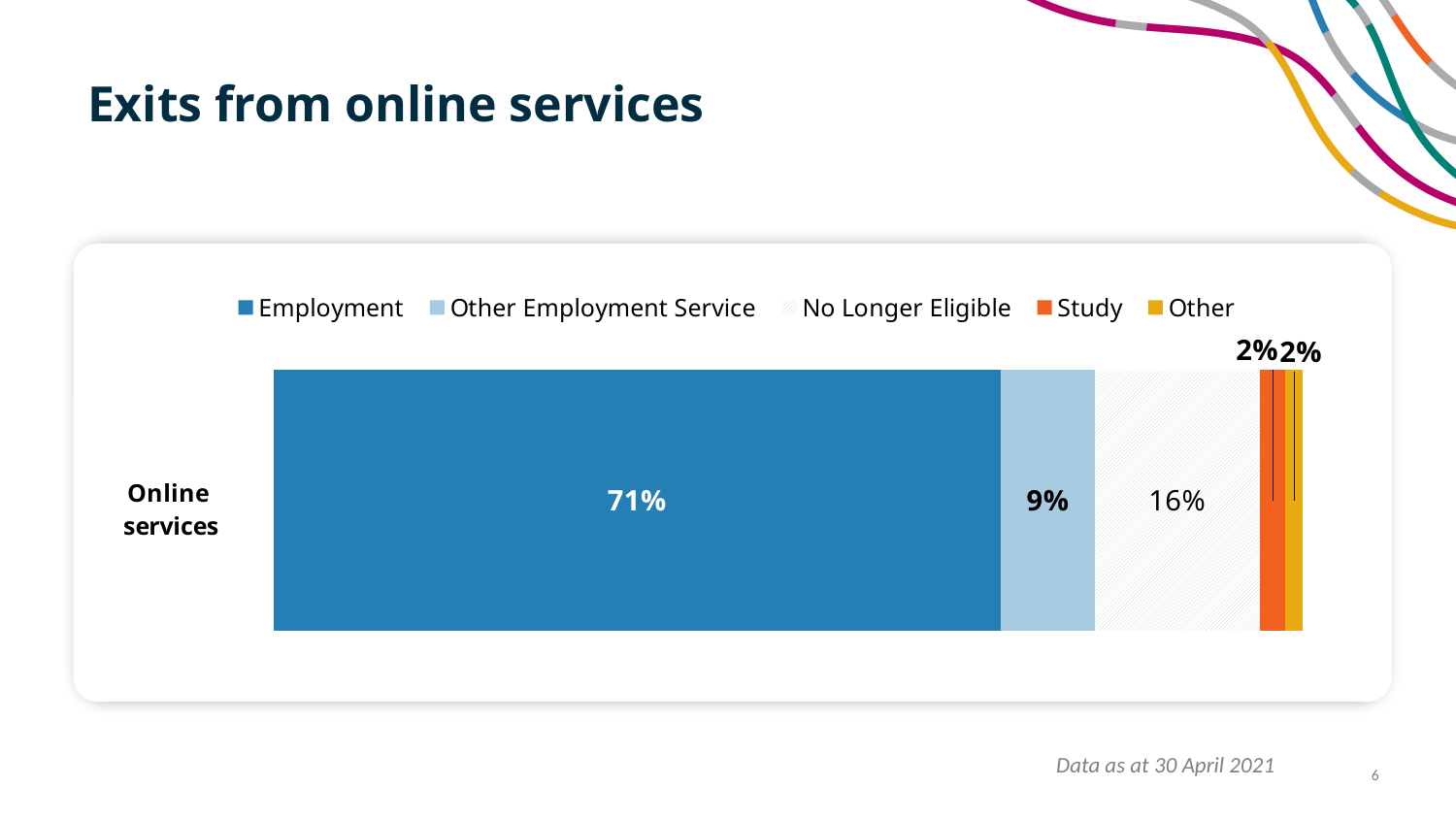
What is the combined share of Study and Other exits from online services? 4% What is the difference in percentage points between the Employment share and the No Longer Eligible share? 55 Which exit reason accounts for the largest share of exits from online services? Employment What kind of chart is shown on the slide? Stacked bar chart How many series does the legend list? 5 What percentage of exits from online services were No Longer Eligible? 16% What share of exits from online services went to Employment? 71% What is the title of the slide containing the chart? Exits from online services Which is larger: the share for No Longer Eligible or the share for Other Employment Service? No Longer Eligible How many categories are plotted on the chart? 1 What percentage of exits from online services were for Study? 2% What percentage of exits from online services were to Other Employment Service? 9%